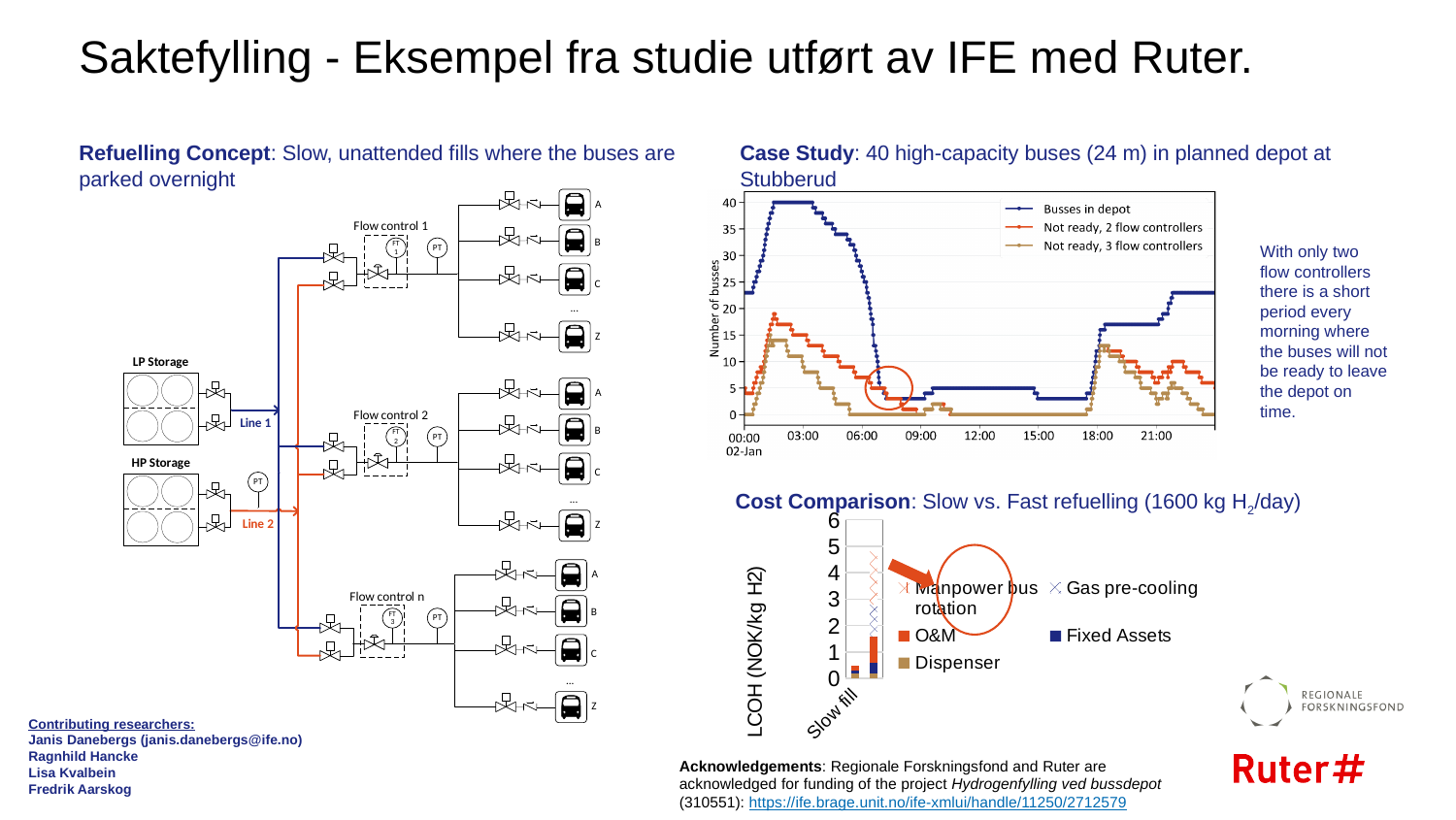
In the Case Study chart (Busses in depot), what is the highest number of busses in depot reached? 40 In the Cost Comparison chart, how many series does the legend list? 5 In the Case Study chart (Busses in depot), what kind of chart is it? line chart In the Case Study chart (Busses in depot), does the number of busses in depot rise or fall between 03:00 and 09:00? fall In the Case Study chart (Busses in depot), how many series does the legend list? 3 In the Case Study chart (Busses in depot), at 06:00 which series is higher: 'Not ready, 2 flow controllers' or 'Not ready, 3 flow controllers'? Not ready, 2 flow controllers In the Case Study chart (Busses in depot), is the number of busses in depot at 21:00 greater or less than 15? greater In the Cost Comparison chart, is the total value of the Slow fill bar greater or less than 2? less In the Cost Comparison chart, what kind of chart is it? bar chart In the Cost Comparison chart, what is the label of the y axis? LCOH (NOK/kg H2) In the Case Study chart (Busses in depot), is the number of busses in depot at 12:00 greater or less than 10? less In the Case Study chart (Busses in depot), what is the label of the y axis? Number of busses